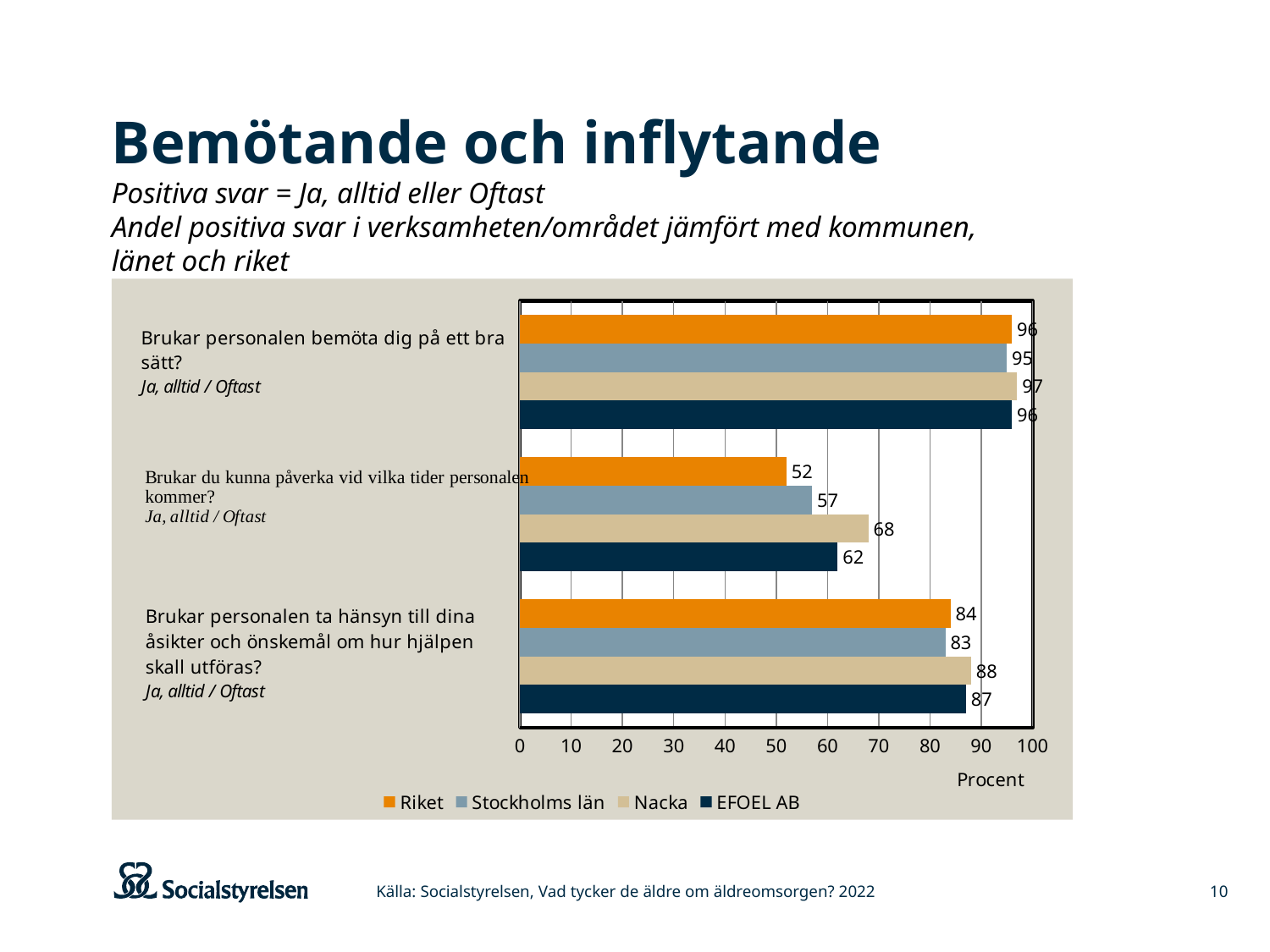
How many questions (categories) are shown on the chart? 3 What is the value for Riket on the question "Brukar personalen ta hänsyn till dina åsikter och önskemål om hur hjälpen skall utföras?"? 84 How many series does the legend list? 4 What kind of chart is shown on the slide? Bar chart What is the difference between Nacka and Riket on the question "Brukar du kunna påverka vid vilka tider personalen kommer?"? 16 What is the value for EFOEL AB on the question "Brukar personalen bemöta dig på ett bra sätt?"? 96 Which series has the highest value on the question "Brukar personalen ta hänsyn till dina åsikter och önskemål om hur hjälpen skall utföras?"? Nacka Is the value for Stockholms län on the question "Brukar du kunna påverka vid vilka tider personalen kommer?" greater or less than 50? greater Which series has the lowest value on the question "Brukar du kunna påverka vid vilka tider personalen kommer?"? Riket What is the label on the horizontal axis of the chart? Procent What is the value for Nacka on the question "Brukar du kunna påverka vid vilka tider personalen kommer?"? 68 Which is larger on the question "Brukar du kunna påverka vid vilka tider personalen kommer?": EFOEL AB or Stockholms län? EFOEL AB